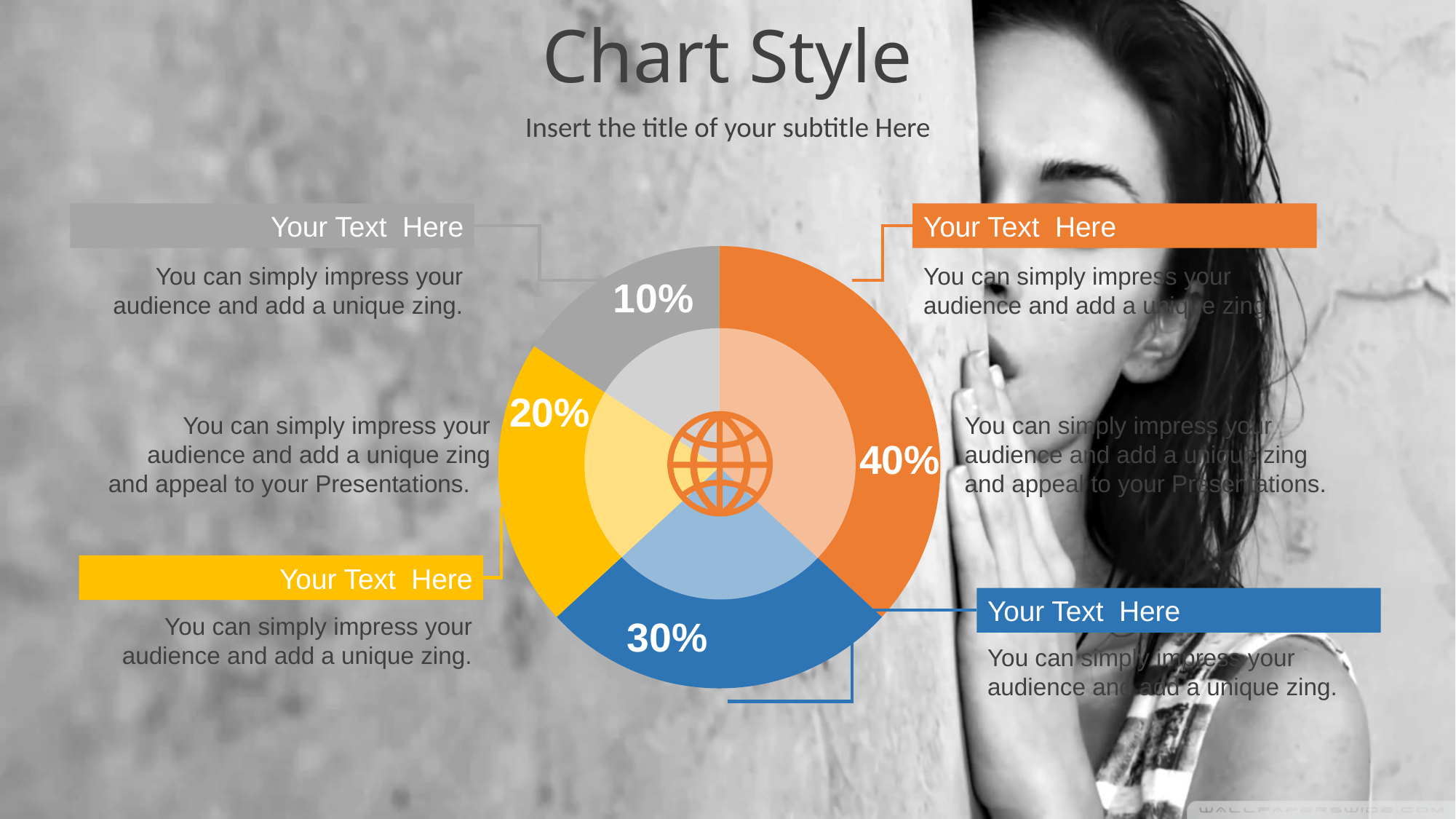
What is the title of the slide containing the pie chart? Chart Style What is the combined share of the orange and gray slices of the pie chart? 50% What kind of chart is shown on the slide? pie chart Which colour slice of the pie chart is the largest? orange Which is larger in the pie chart, the yellow slice or the blue slice? the blue slice Which colour slice of the pie chart is the smallest? gray What percentage is shown on the orange slice of the pie chart? 40% What is the difference between the orange slice and the blue slice of the pie chart? 10% How many slices does the pie chart have? 4 What percentage is shown on the gray slice of the pie chart? 10% What percentage is shown on the blue slice of the pie chart? 30% What percentage is shown on the yellow slice of the pie chart? 20%